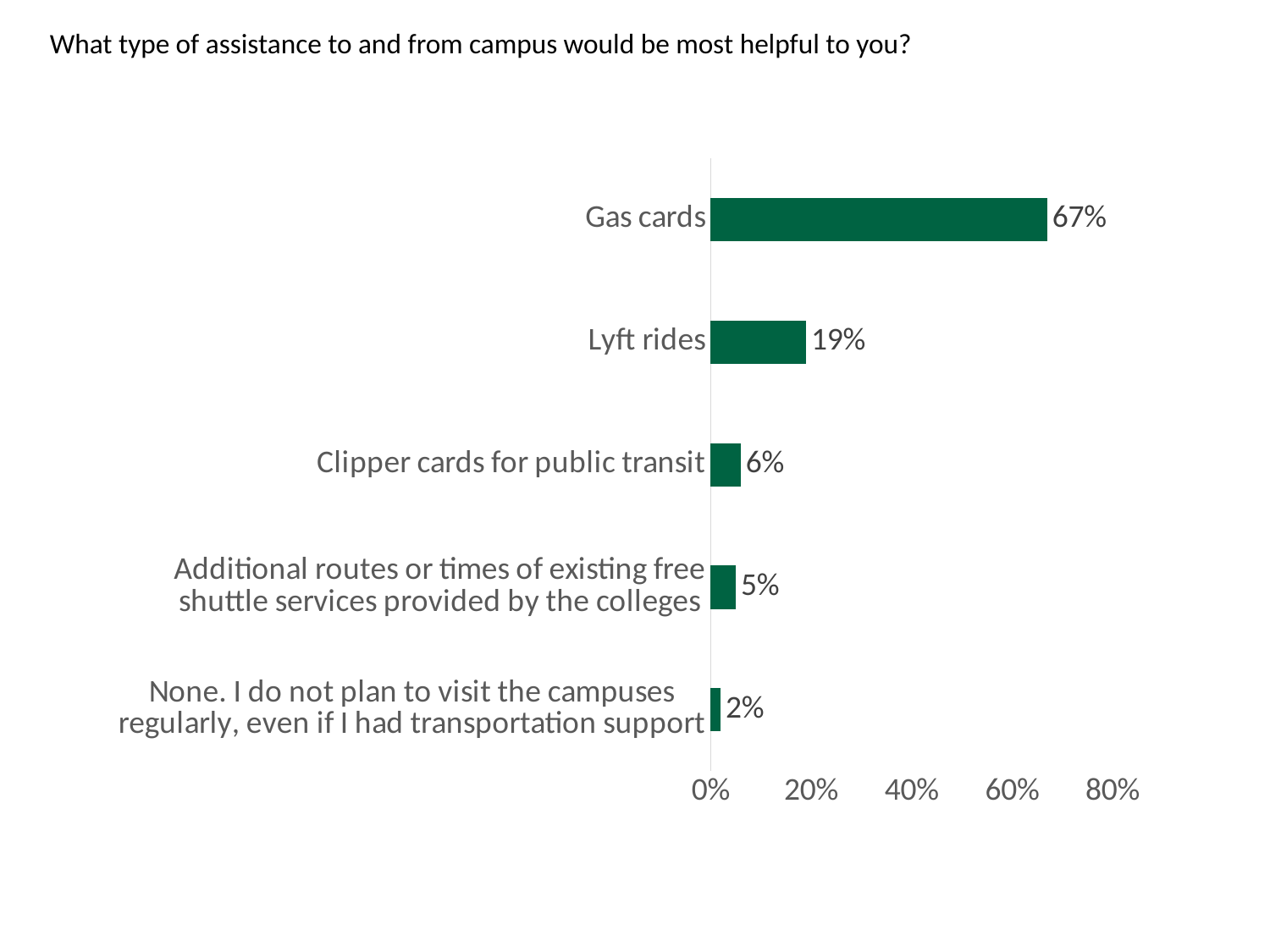
Is the value for Gas cards greater or less than 60%? greater How many categories are shown in the chart? 5 What kind of chart is shown on the slide? Bar chart What is the difference between the values for Gas cards and Lyft rides? 48% What is the title of the chart? What type of assistance to and from campus would be most helpful to you? Which category has the lowest value? None. I do not plan to visit the campuses regularly, even if I had transportation support What is the value for Lyft rides? 19% Which category has the highest value? Gas cards Which is larger, the value for Lyft rides or the value for Clipper cards for public transit? Lyft rides What is the value for Gas cards? 67% What is the value for Clipper cards for public transit? 6% What is the value for Additional routes or times of existing free shuttle services provided by the colleges? 5%